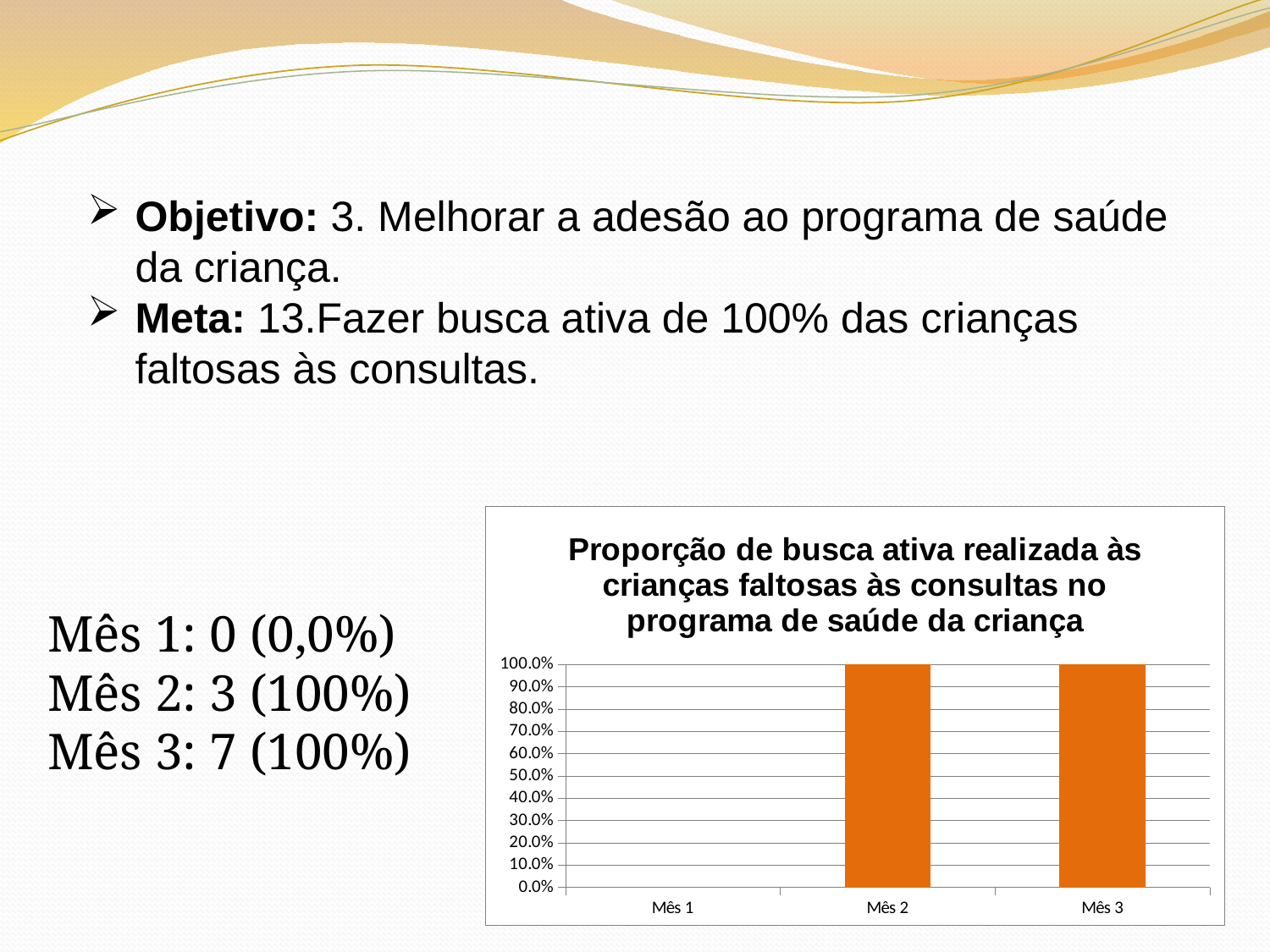
What is the difference between the values for Mês 2 and Mês 1 in the chart? 100.0% What colour are the bars in the chart? orange Is the value for Mês 3 greater or less than 50.0%? greater Do the values rise or fall from Mês 1 to Mês 2 in the chart? rise Which month has the lowest value in the chart? Mês 1 How many categories (months) are shown on the x axis of the chart? 3 Which is larger in the chart, the value for Mês 1 or the value for Mês 2? Mês 2 What kind of chart is shown on the slide? bar chart What is the value for Mês 3 in the chart? 100.0% What is the value for Mês 2 in the chart? 100.0% What is the title of the chart? Proporção de busca ativa realizada às crianças faltosas às consultas no programa de saúde da criança What is the value for Mês 1 in the chart? 0.0%